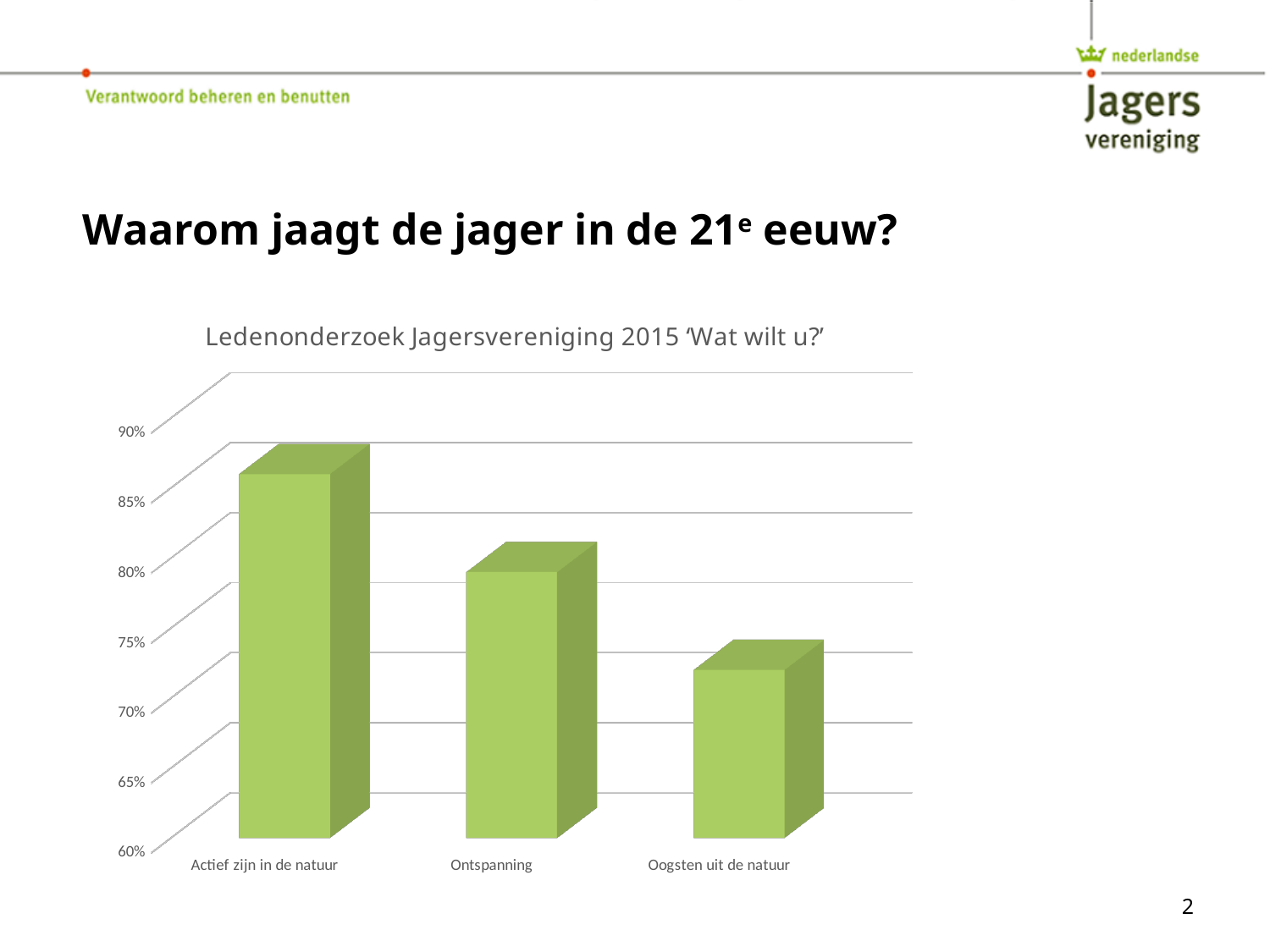
Is the value for Oogsten uit de natuur greater or less than 70%? greater Which is larger, the value for Ontspanning or the value for Oogsten uit de natuur? Ontspanning Is the value for Ontspanning greater or less than 75%? greater Is the value for Ontspanning greater or less than 85%? less Which category has the lowest value? Oogsten uit de natuur What kind of chart is shown on the slide? Bar chart Which category has the highest value? Actief zijn in de natuur What is the title of the chart? Ledenonderzoek Jagersvereniging 2015 ‘Wat wilt u?’ How many categories are shown in the chart? 3